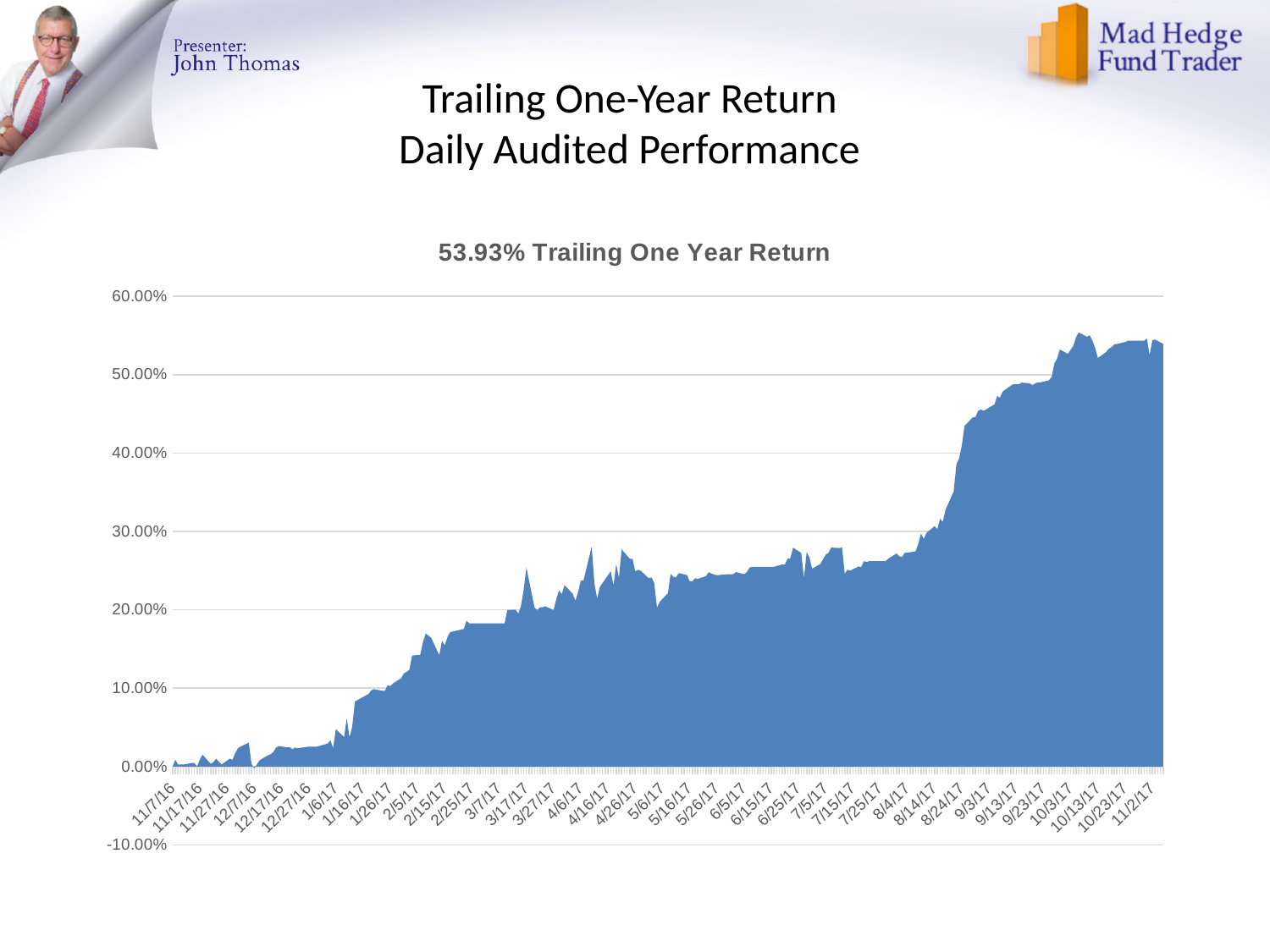
Overall, do the values rise or fall from 11/7/16 to 11/2/17? Rise What kind of chart is shown on the slide? Area chart Is the value for 11/7/16 greater or less than 10.00%? less What is the highest value shown on the vertical axis? 60.00% Is the value for 9/3/17 greater or less than 40.00%? greater What is the title of the chart? 53.93% Trailing One Year Return Is the value for 11/2/17 greater or less than 50.00%? greater What trailing one year return figure is stated in the chart title? 53.93% Which of 1/6/17 and 10/3/17 has the larger value? 10/3/17